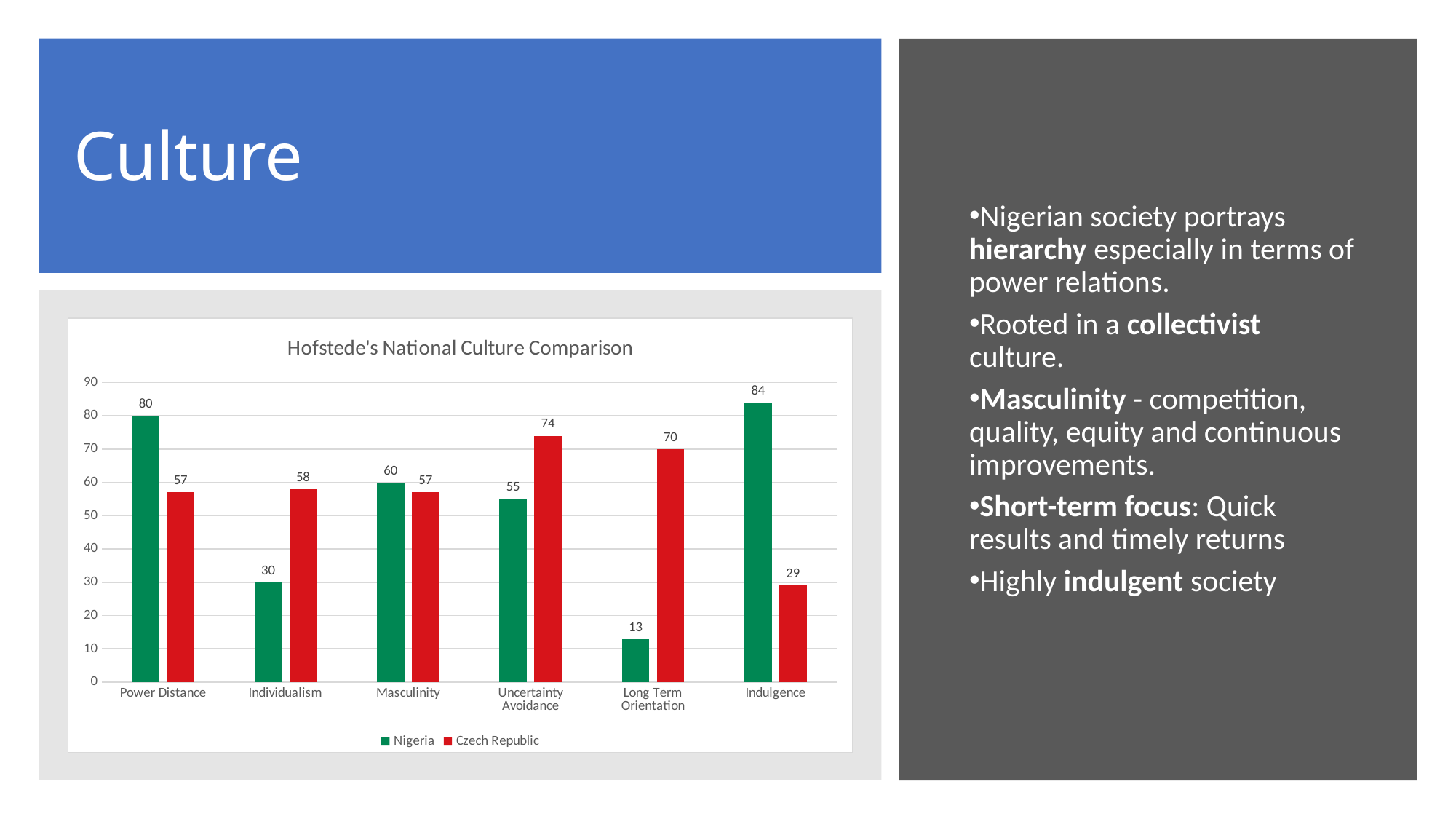
Which category has the lowest value for the Czech Republic? Indulgence What is the value for the Czech Republic on Uncertainty Avoidance? 74 What kind of chart is shown on the slide? Bar chart Which is larger on Individualism, Nigeria or the Czech Republic? Czech Republic Which category has the highest value for Nigeria? Indulgence How many categories are shown on the x axis? 6 What is the value for Nigeria on Power Distance? 80 How many series does the legend list? 2 What is the value for Nigeria on Long Term Orientation? 13 What is the difference between Nigeria and the Czech Republic on Long Term Orientation? 57 What is the title of the chart? Hofstede's National Culture Comparison Is the value for Nigeria on Uncertainty Avoidance greater or less than 60? less